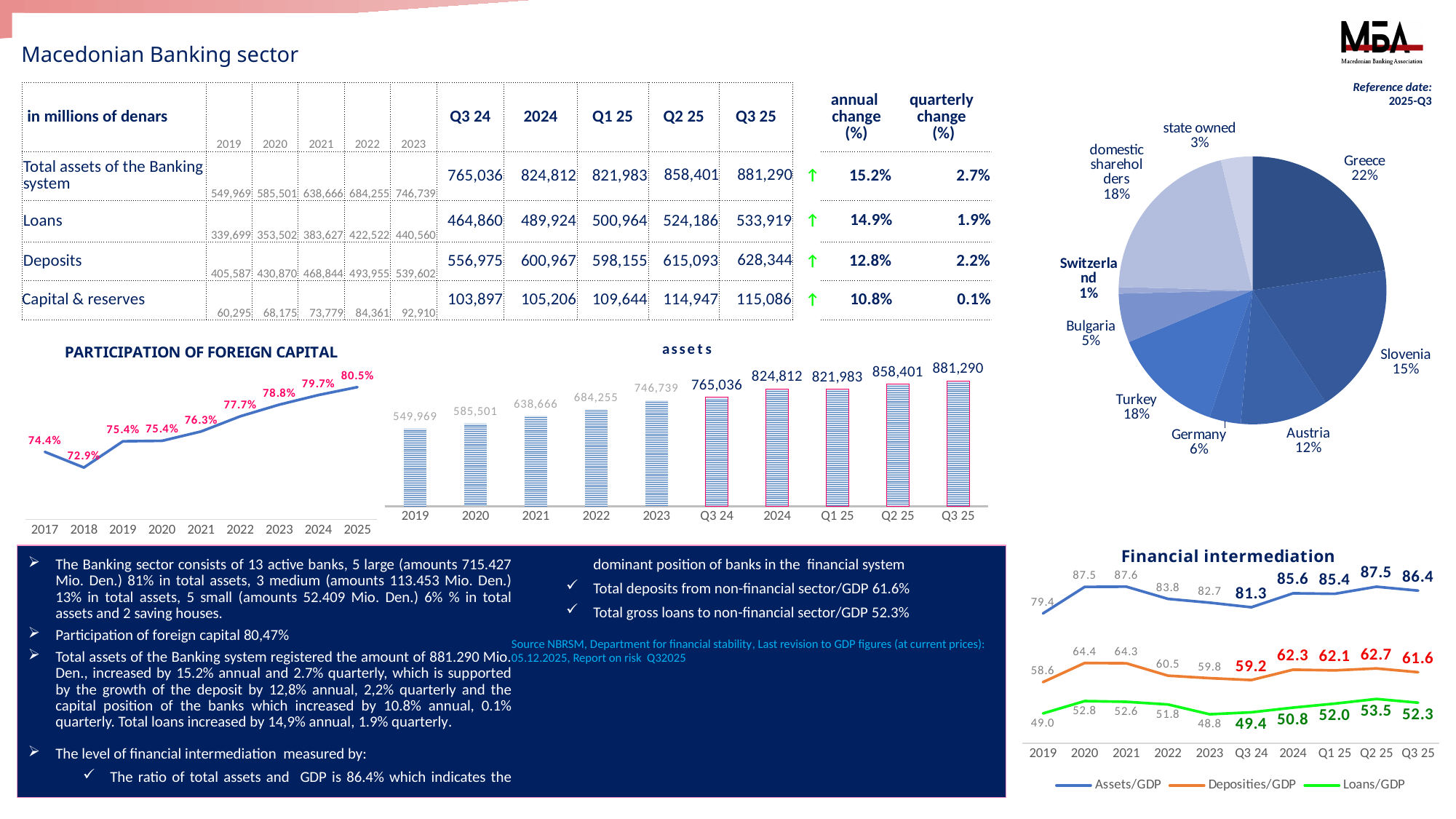
In the 'assets' bar chart, what is the difference between the 2024 value and the 2023 value? 78,073 What kind of chart is the 'assets' chart? bar chart In the 'Financial intermediation' chart, what is the Loans/GDP value for Q2 25? 53.5 In the pie chart at the top right, which slice is the smallest? Switzerland In the 'assets' bar chart, which is larger, the value for 2024 or the value for Q1 25? 2024 In the 'Financial intermediation' chart, what is the difference between the Assets/GDP value and the Deposities/GDP value for Q3 25? 24.8 In the 'PARTICIPATION OF FOREIGN CAPITAL' chart, which year has the lowest value? 2018 In the pie chart at the top right, what share does Greece have? 22% In the 'PARTICIPATION OF FOREIGN CAPITAL' chart, what is the value for 2025? 80.5% In the 'assets' bar chart, what is the value for Q3 25? 881,290 In the 'PARTICIPATION OF FOREIGN CAPITAL' chart, how many years are plotted? 9 How many series does the legend of the 'Financial intermediation' chart list? 3